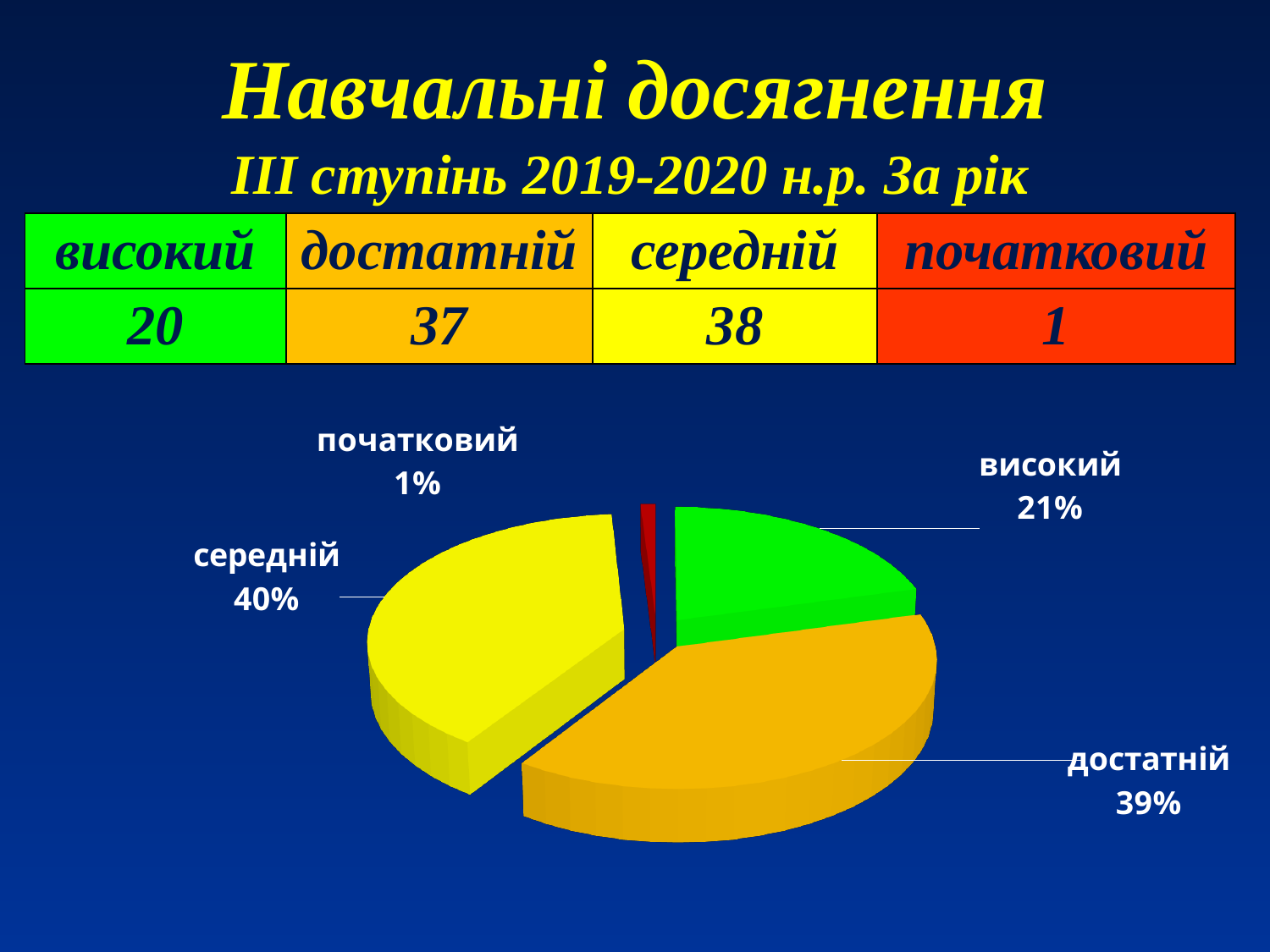
What is the difference between the share for "достатній" and the share for "початковий"? 38% Which category has the largest slice of the pie? середній What share of the pie does the "середній" slice represent? 40% How many slices does the pie chart have? 4 What colour is the "високий" slice of the pie? green Which is larger, the share for "високий" or the share for "початковий"? високий What share of the pie does the "високий" slice represent? 21% What share of the pie does the "початковий" slice represent? 1% What is the difference between the share for "середній" and the share for "високий"? 19% What kind of chart is shown on the slide? pie chart Which category has the smallest slice of the pie? початковий